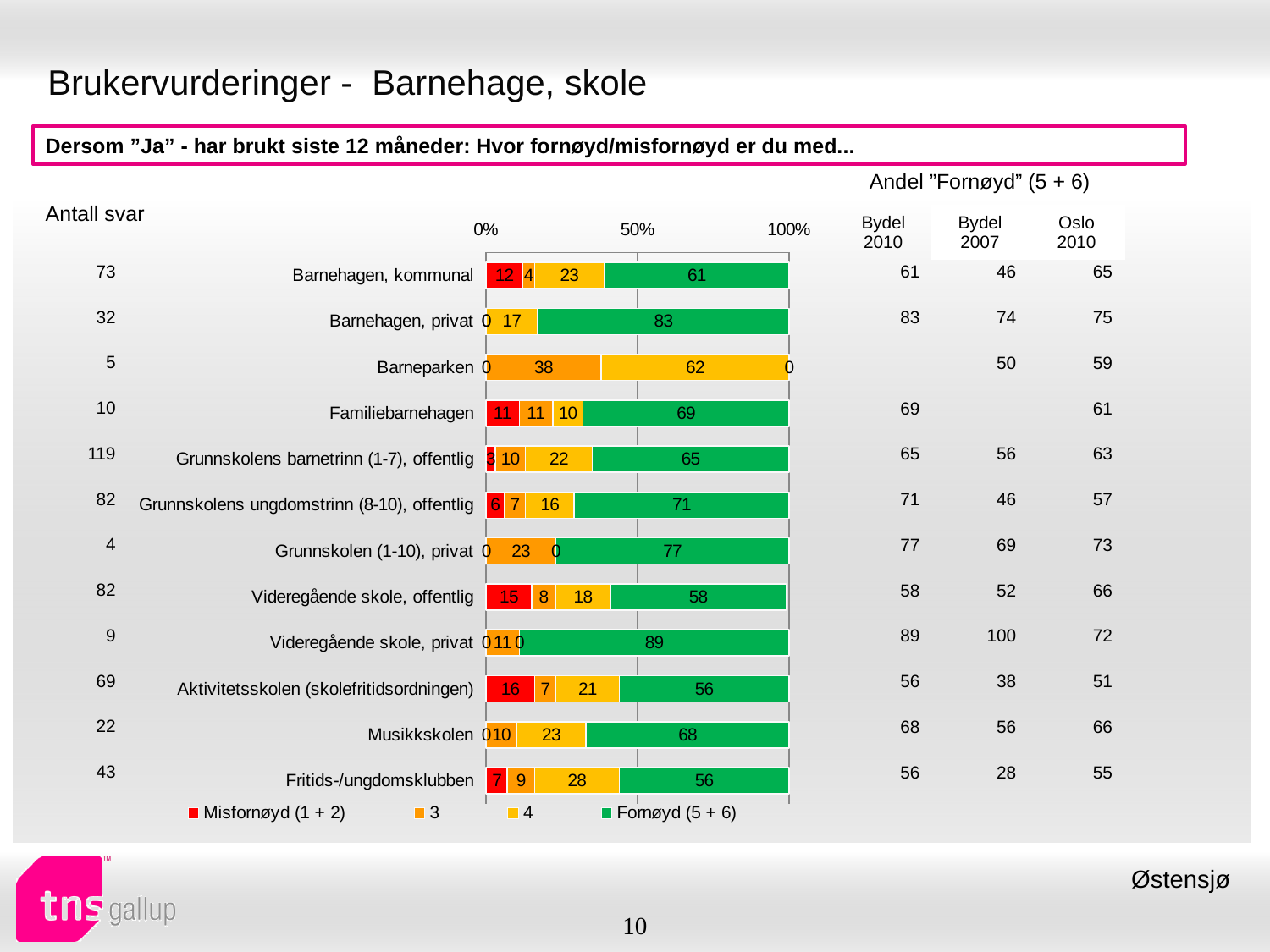
What is the value of the '4' segment for Fritids-/ungdomsklubben? 28 What is the value of the Misfornøyd (1 + 2) segment for Videregående skole, offentlig? 15 What is the value of the Fornøyd (5 + 6) segment for Barnehagen, kommunal? 61 What is the first entry in the chart legend? Misfornøyd (1 + 2) Is the Fornøyd (5 + 6) value for Familiebarnehagen greater or less than 50%? greater How many series does the legend list? 4 What is the difference between the Fornøyd (5 + 6) values for Videregående skole, privat and Videregående skole, offentlig? 31 How many categories are shown in the bar chart? 12 What is the value of the '3' segment for Barneparken? 38 What kind of chart is shown on the slide? stacked bar chart Which category has the highest Fornøyd (5 + 6) value? Videregående skole, privat Which has a larger Fornøyd (5 + 6) value, Barnehagen, privat or Barnehagen, kommunal? Barnehagen, privat